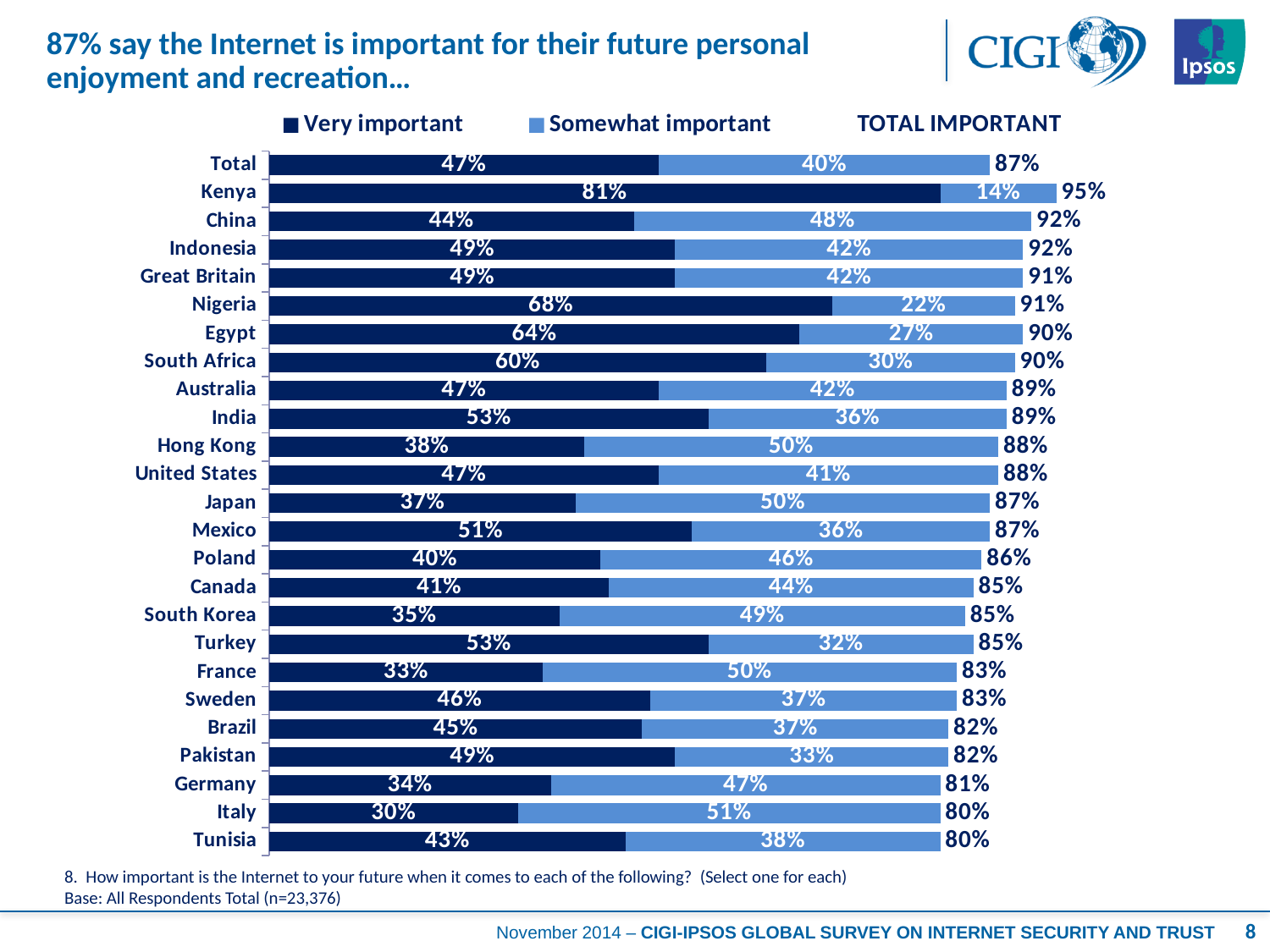
How many series does the legend list? 3 What is the 'Somewhat important' value for Hong Kong? 50% What kind of chart is shown on the slide? Stacked bar chart What is the TOTAL IMPORTANT value shown for Germany? 81% What is the difference between the 'Very important' values for Nigeria and Japan? 31 percentage points What is the total of the stacked bar for South Africa (Very important plus Somewhat important)? 90% What colour represents the 'Very important' series in the chart? Dark blue How many categories (rows) are plotted in the chart? 25 What percentage of respondents in Kenya say the Internet is very important for their future personal enjoyment and recreation? 81% Which country has the highest 'Very important' percentage? Kenya Which country has the lowest 'Very important' percentage? Italy Which has a larger 'Somewhat important' value, China or Egypt? China